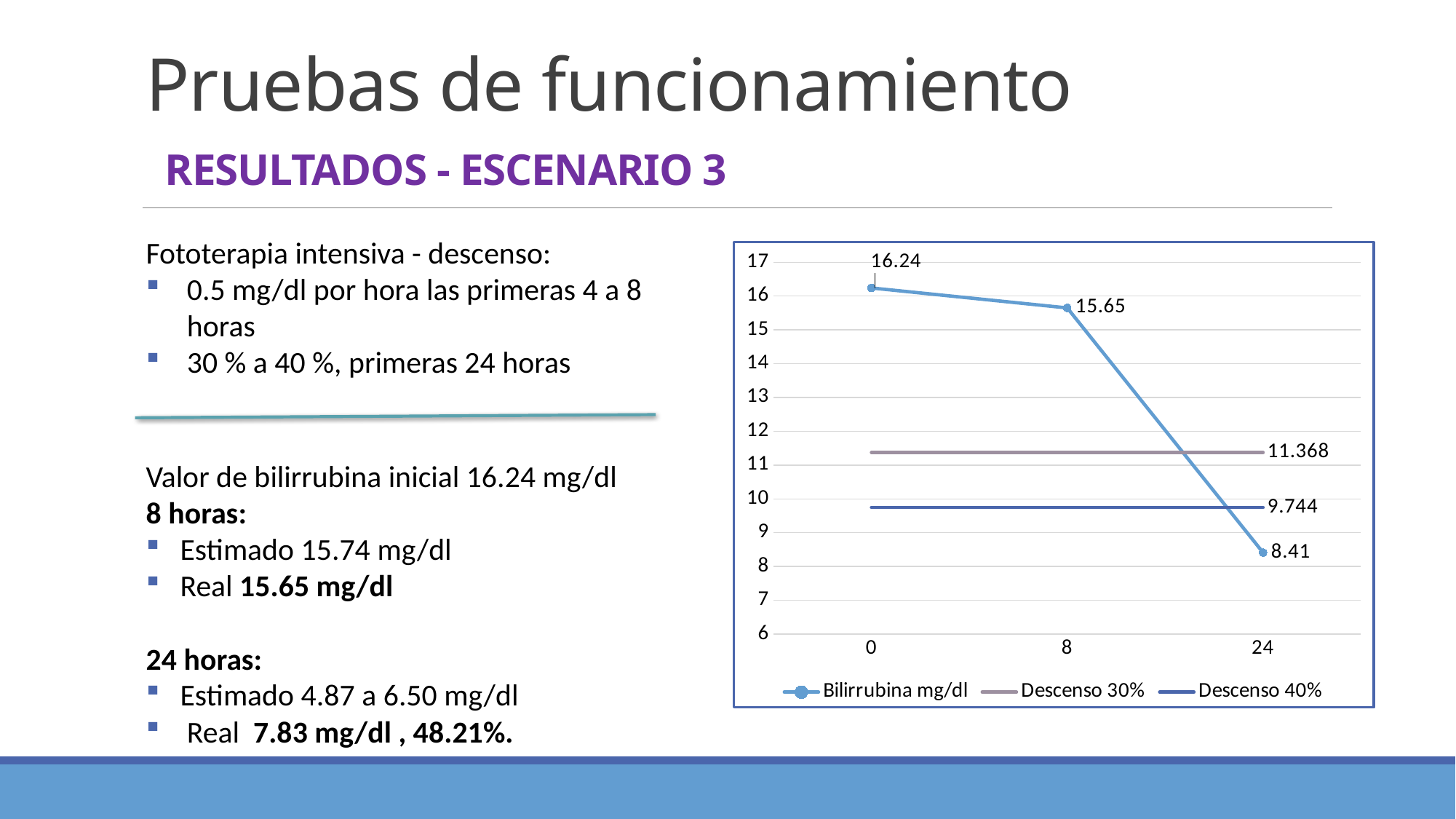
What is the value of Bilirrubina mg/dl at hour 0? 16.24 How many x-axis points are plotted for the Bilirrubina mg/dl series? 3 How many series does the chart legend list? 3 Which is larger, the Descenso 30% value or the Descenso 40% value? Descenso 30% What is the difference between the Bilirrubina mg/dl values at hour 0 and hour 24? 7.83 Does the Bilirrubina mg/dl line rise or fall from hour 0 to hour 24? fall What value is labelled on the Descenso 40% line? 9.744 What type of chart is shown on the slide? line chart At which x-axis point is the Bilirrubina mg/dl value lowest? 24 What is the value of Bilirrubina mg/dl at hour 24? 8.41 What is the value of Bilirrubina mg/dl at hour 8? 15.65 What value is labelled on the Descenso 30% line? 11.368